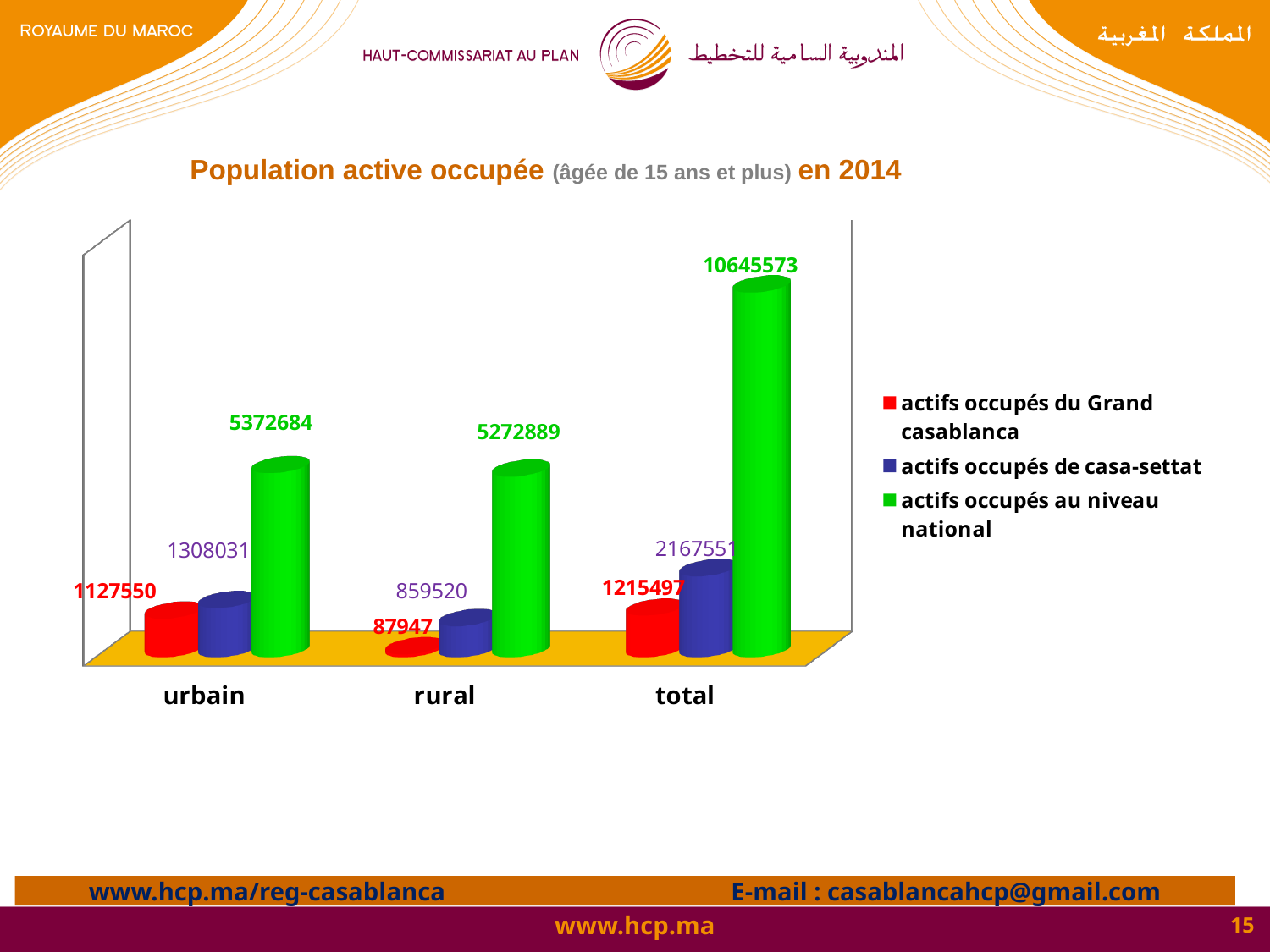
What colour represents 'actifs occupés au niveau national' in the chart? green What is the value for 'actifs occupés de casa-settat' in the 'urbain' category? 1308031 How many categories are shown on the x axis? 3 Which is larger in the 'rural' category: 'actifs occupés de casa-settat' or 'actifs occupés du Grand casablanca'? actifs occupés de casa-settat What is the value for 'actifs occupés du Grand casablanca' in the 'rural' category? 87947 What is the value for 'actifs occupés du Grand casablanca' in the 'urbain' category? 1127550 What is the difference between 'actifs occupés de casa-settat' and 'actifs occupés du Grand casablanca' in the 'total' category? 952054 How many series does the legend list? 3 Which category has the highest value for 'actifs occupés de casa-settat'? total What is the value for 'actifs occupés au niveau national' in the 'total' category? 10645573 Which category has the lowest value for 'actifs occupés du Grand casablanca'? rural What kind of chart is shown on the slide? bar chart